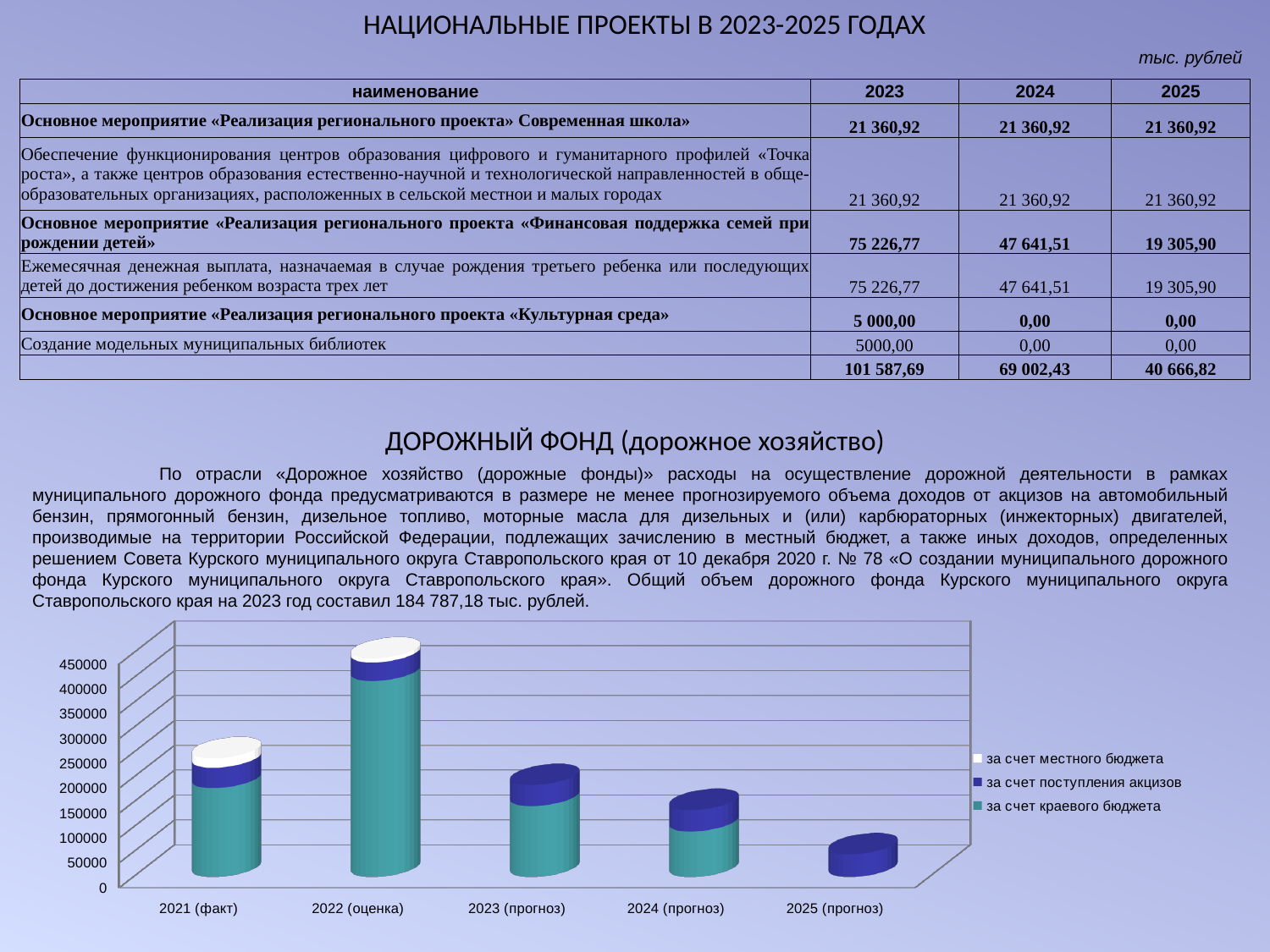
Which category has the shortest stacked bar in the chart? 2025 (прогноз) Is the total of the stacked bar for 2021 (факт) greater or less than 200000? greater How many categories are shown on the x axis of the bar chart? 5 Is the total of the stacked bar for 2024 (прогноз) greater or less than 200000? less How many series does the legend of the bar chart list? 3 Is the total of the stacked bar for 2022 (оценка) greater or less than 400000? greater Which category has the tallest stacked bar in the chart? 2022 (оценка) From 2022 (оценка) to 2025 (прогноз), do the stacked bar totals rise or fall? Fall Which legend entry of the bar chart is shown in white? за счет местного бюджета Which stacked bar is taller: 2021 (факт) or 2023 (прогноз)? 2021 (факт) What kind of chart is shown at the bottom of the slide under «ДОРОЖНЫЙ ФОНД»? Bar chart (stacked) Which stacked bar is taller: 2024 (прогноз) or 2025 (прогноз)? 2024 (прогноз)